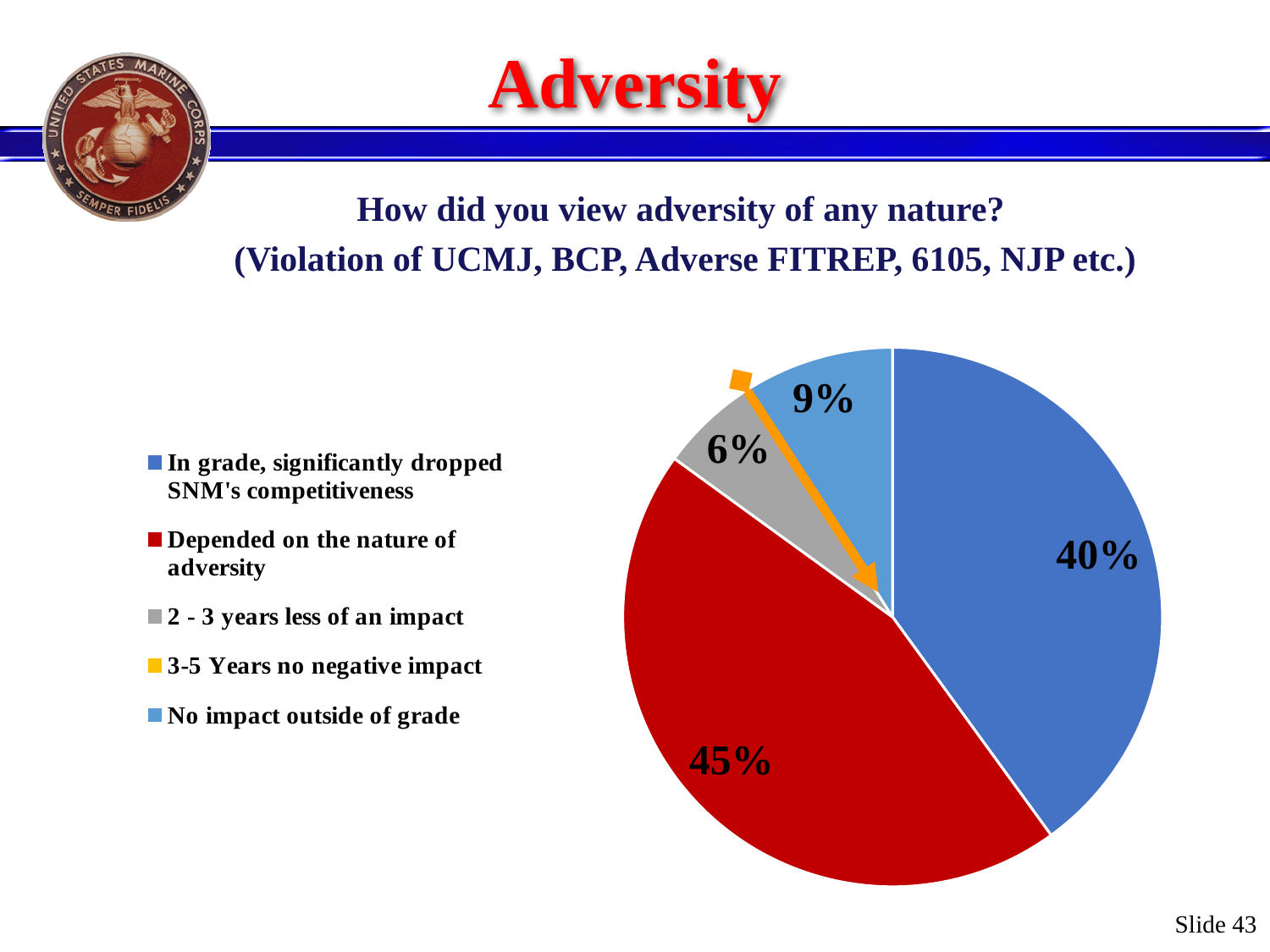
What question does the pie chart answer, according to the text above it? How did you view adversity of any nature? What colour is the slice representing 'Depended on the nature of adversity'? red What kind of chart is shown on the slide? pie chart Which response category has the largest share of the pie? Depended on the nature of adversity Which is larger: the share for 'Depended on the nature of adversity' or the share for 'In grade, significantly dropped SNM's competitiveness'? Depended on the nature of adversity How many categories does the legend of the pie chart list? 5 What percentage of respondents chose 'No impact outside of grade'? 9% What percentage of respondents said adversity 'In grade, significantly dropped SNM's competitiveness'? 40% What is the difference in percentage points between the 'No impact outside of grade' slice and the '2 - 3 years less of an impact' slice? 3% What percentage of respondents chose '2 - 3 years less of an impact'? 6% What is the difference in percentage points between the 'Depended on the nature of adversity' slice and the 'In grade, significantly dropped SNM's competitiveness' slice? 5% What percentage of respondents said adversity 'Depended on the nature of adversity'? 45%